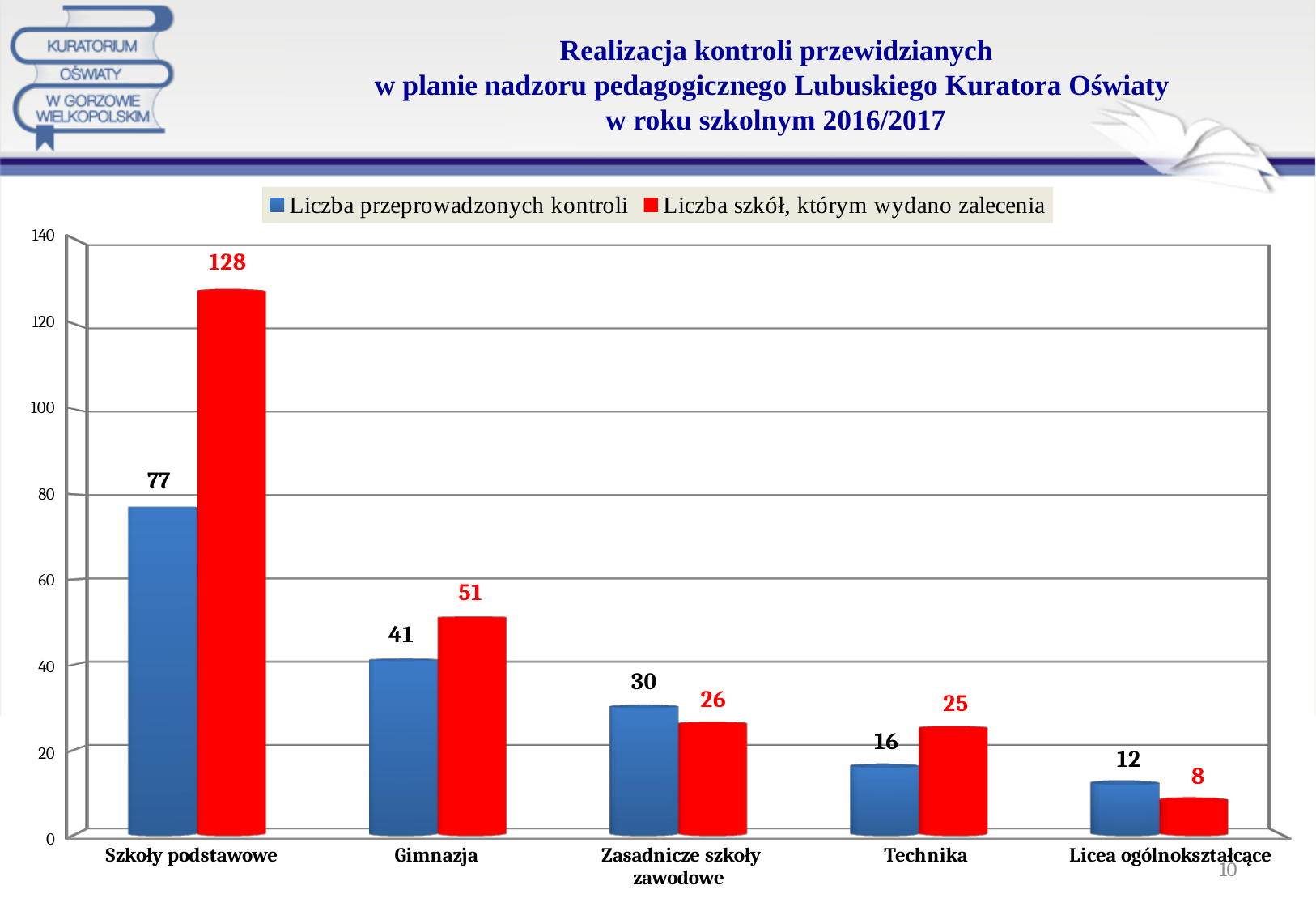
What kind of chart is shown on the slide? bar chart What is the value of "Liczba szkół, którym wydano zalecenia" for Gimnazja? 51 Which category has the highest value for "Liczba szkół, którym wydano zalecenia"? Szkoły podstawowe How many series does the legend list? 2 For Zasadnicze szkoły zawodowe, which is larger: "Liczba przeprowadzonych kontroli" or "Liczba szkół, którym wydano zalecenia"? Liczba przeprowadzonych kontroli How many categories are shown on the x axis? 5 What is the value of "Liczba szkół, którym wydano zalecenia" for Licea ogólnokształcące? 8 What is the difference between "Liczba szkół, którym wydano zalecenia" and "Liczba przeprowadzonych kontroli" for Szkoły podstawowe? 51 What is the value of "Liczba przeprowadzonych kontroli" for Szkoły podstawowe? 77 Which category has the lowest value for "Liczba przeprowadzonych kontroli"? Licea ogólnokształcące Is the value of "Liczba szkół, którym wydano zalecenia" for Szkoły podstawowe greater or less than 120? greater Do the values of "Liczba przeprowadzonych kontroli" rise or fall from left to right along the x axis? fall